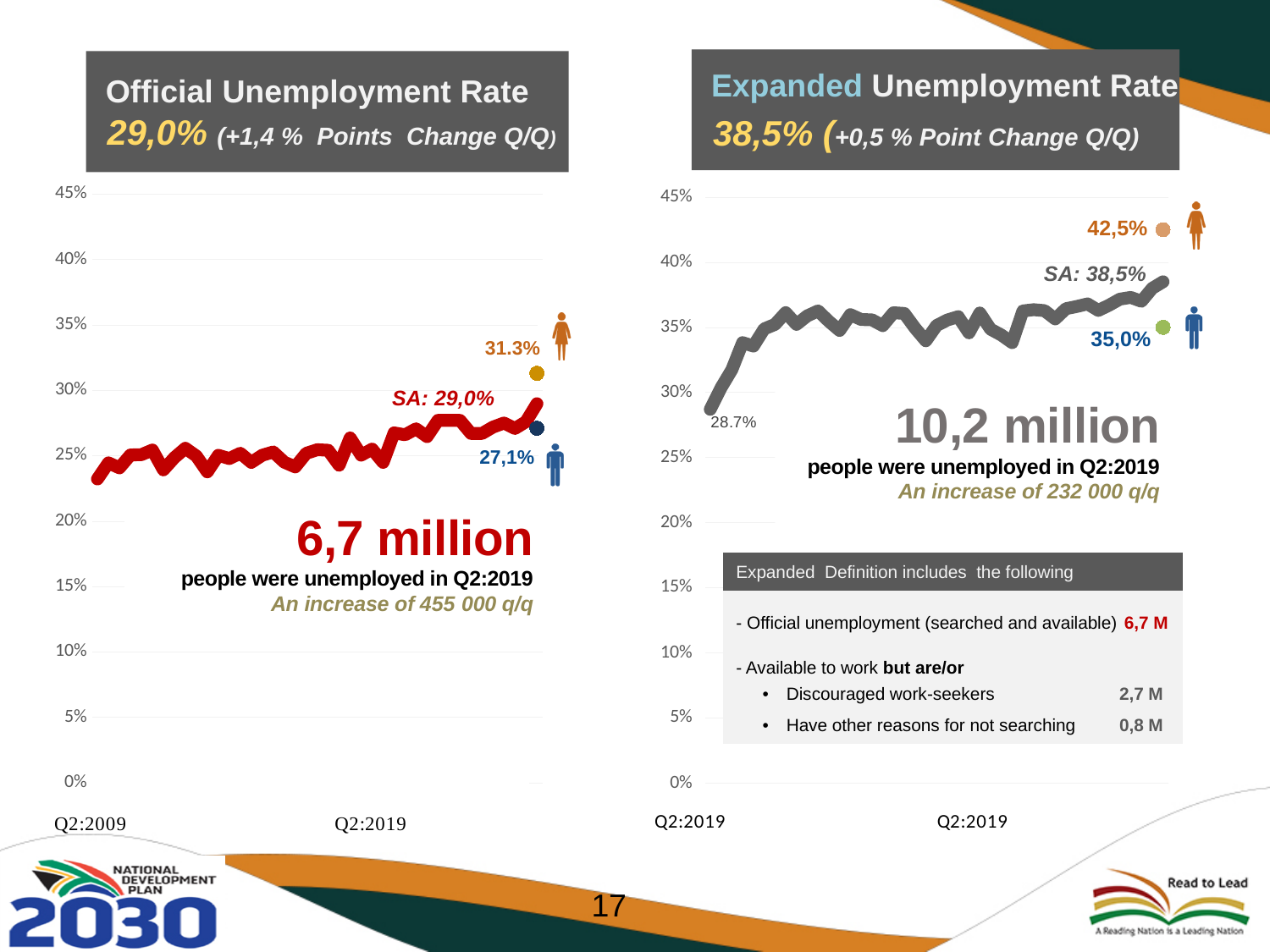
On the Official Unemployment Rate chart, what value is labelled next to the orange (female) marker? 31.3% On the Official Unemployment Rate chart, what value is labelled next to the blue (male) marker? 27,1% On the Official Unemployment Rate chart, does the line generally rise or fall from Q2:2009 to Q2:2019? rise On the Expanded Unemployment Rate chart, what is the difference between the female marker value (42,5%) and the male marker value (35,0%)? 7,5 percentage points On the Official Unemployment Rate chart, which labelled value is higher: the female marker or the male marker? female marker (31.3%) On the Expanded Unemployment Rate chart, what is the SA value labelled at the end of the line? 38,5% On the Official Unemployment Rate chart, what is the SA value labelled at the end of the line? 29,0% On the Expanded Unemployment Rate chart, what value is labelled next to the orange (female) marker? 42,5% On the Expanded Unemployment Rate chart, is the SA value of 38,5% greater or less than 40%? less What kind of chart is the Official Unemployment Rate chart? line chart On the Expanded Unemployment Rate chart, what value is labelled at the start of the line? 28.7% What is the highest value shown on the y axis of the Expanded Unemployment Rate chart? 45%